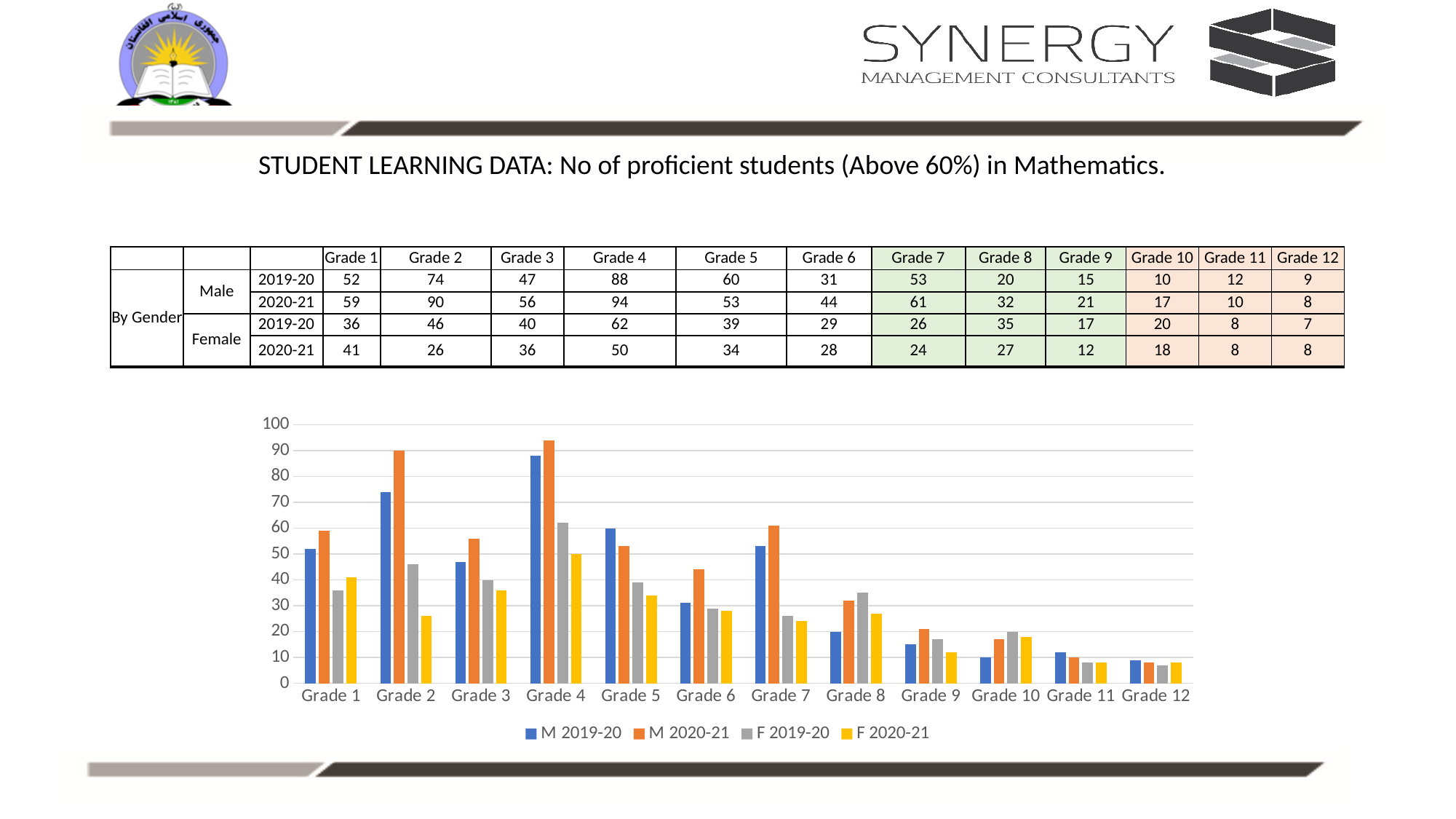
For which grade is the M 2020-21 bar the highest? Grade 4 For which grade is the F 2019-20 bar the lowest? Grade 12 Is the value for M 2020-21 at Grade 2 greater or less than 80? greater At Grade 7, which is larger: M 2020-21 or F 2019-20? M 2020-21 Is the value for F 2019-20 at Grade 4 greater or less than 50? greater What kind of chart is shown on the slide? bar chart What is the value of M 2019-20 for Grade 4? 88 How many grade categories are shown on the x axis of the chart? 12 How many series does the chart legend list? 4 Do the M 2020-21 values rise or fall from Grade 7 to Grade 12? fall What colour represents the F 2020-21 series in the chart? yellow What is the difference between M 2020-21 and F 2020-21 at Grade 2? 64